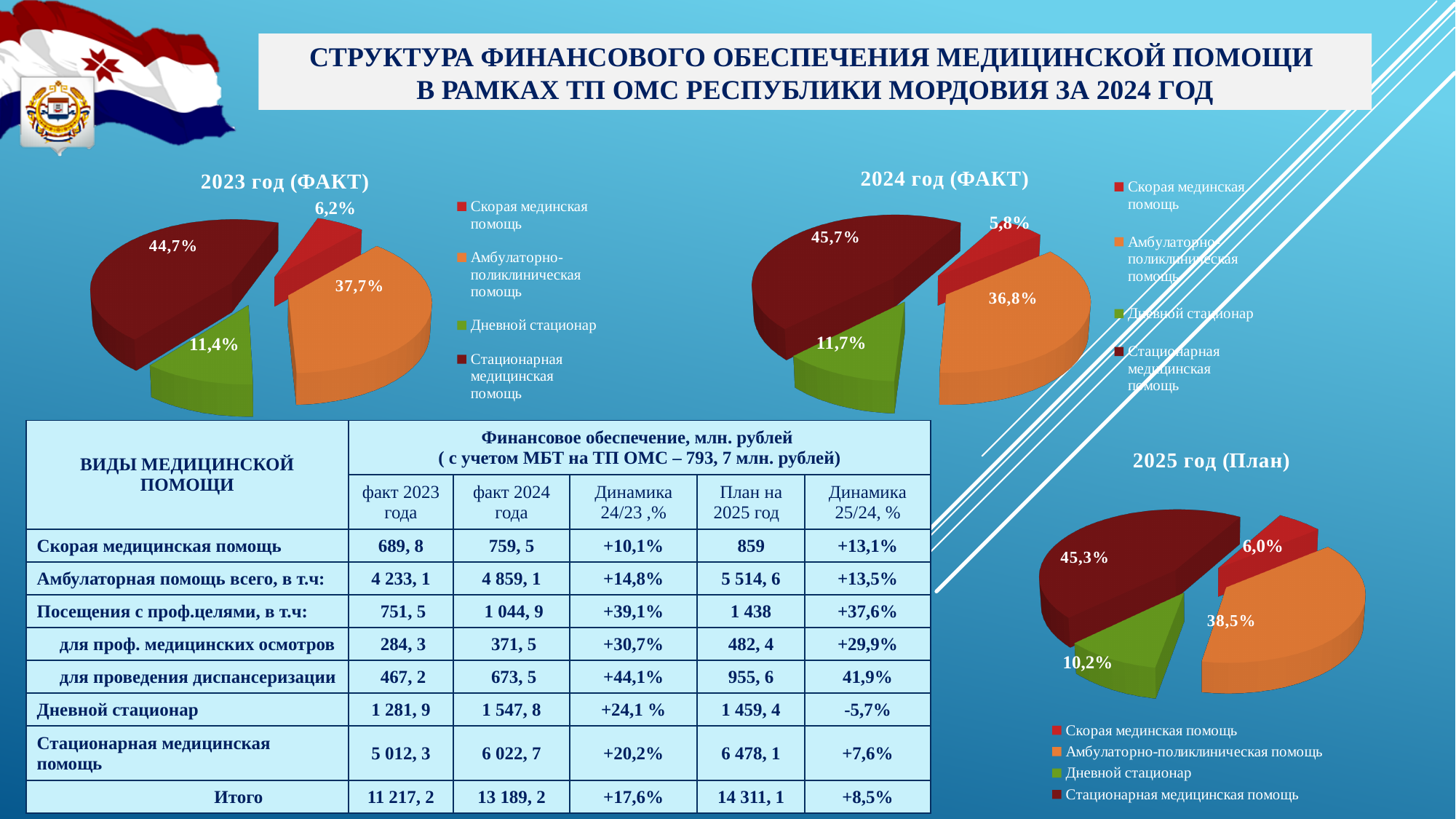
In the "2025 год (План)" pie chart, what share is shown for Дневной стационар? 10,2% How many entries does the legend of the "2024 год (ФАКТ)" chart list? 4 What type of chart is "2023 год (ФАКТ)"? Pie chart In the "2023 год (ФАКТ)" pie chart, which category has the largest slice? Стационарная медицинская помощь In the "2023 год (ФАКТ)" pie chart, which is larger: Дневной стационар or Скорая мединская помощь? Дневной стационар How many slices does the "2025 год (План)" pie chart have? 4 In the "2024 год (ФАКТ)" pie chart, what share is shown for Скорая мединская помощь? 5,8% In the "2025 год (План)" pie chart, what colour is the slice for Амбулаторно-поликлиническая помощь? Orange In the "2024 год (ФАКТ)" pie chart, what is the difference in percentage points between Стационарная медицинская помощь and Амбулаторно-поликлиническая помощь? 8,9 In the "2025 год (План)" pie chart, which category has the smallest slice? Скорая мединская помощь In the "2024 год (ФАКТ)" pie chart, what share is shown for Амбулаторно-поликлиническая помощь? 36,8% In the "2023 год (ФАКТ)" pie chart, what share is shown for Стационарная медицинская помощь? 44,7%